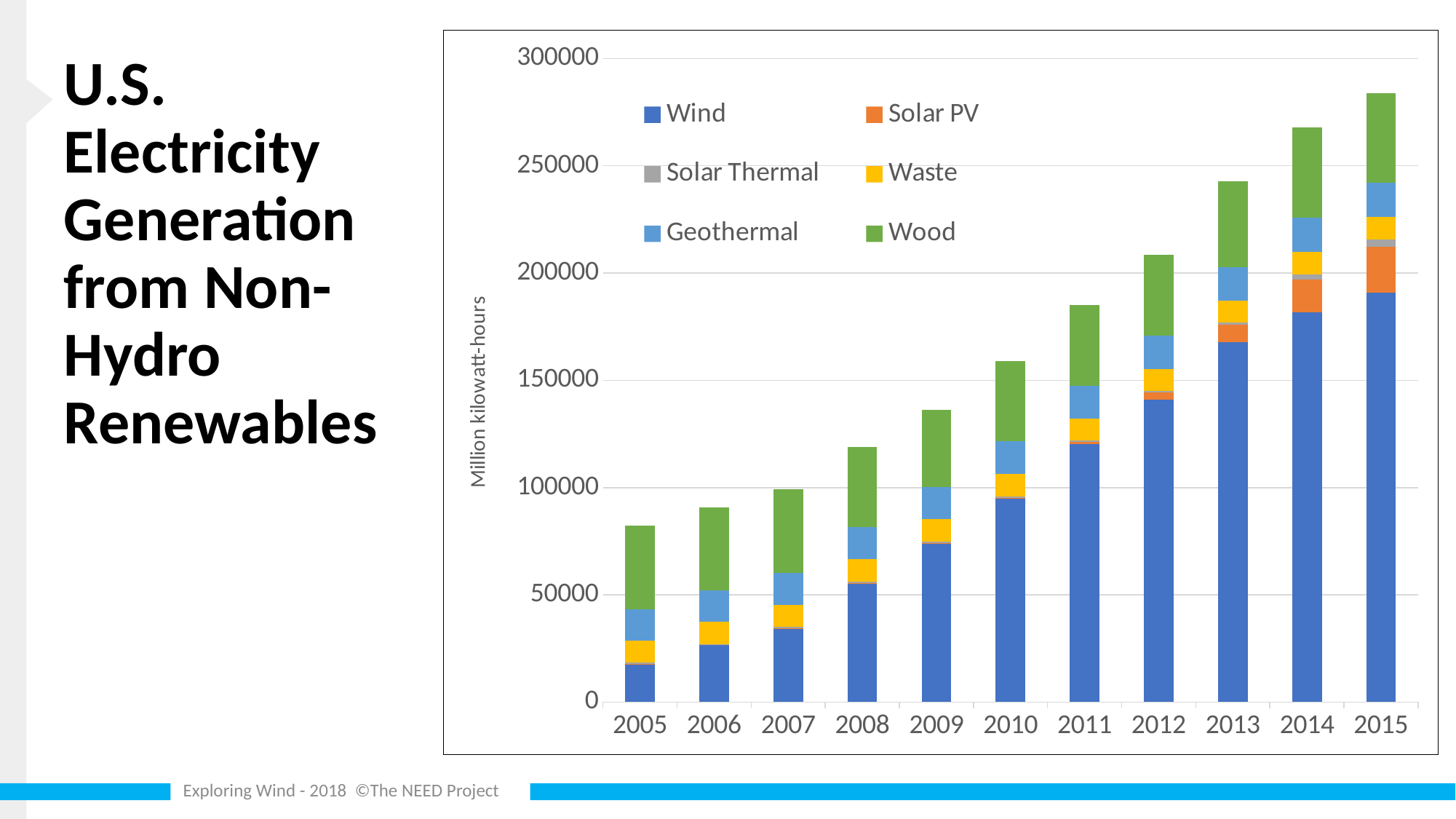
How many series does the legend list? 6 Is the Wind value for 2015 greater or less than 150000? greater Which year has the highest total non-hydro renewable generation? 2015 What kind of chart is shown on the slide? Stacked bar chart How many years are shown on the x axis? 11 Is the Wind value for 2012 greater or less than 100000? greater Is the total bar for 2005 greater or less than 100000? less Which year has a larger total bar, 2008 or 2012? 2012 Which year has the lowest total non-hydro renewable generation? 2005 What is the label on the vertical axis? Million kilowatt-hours Do the total bar heights rise or fall from 2005 to 2015? Rise